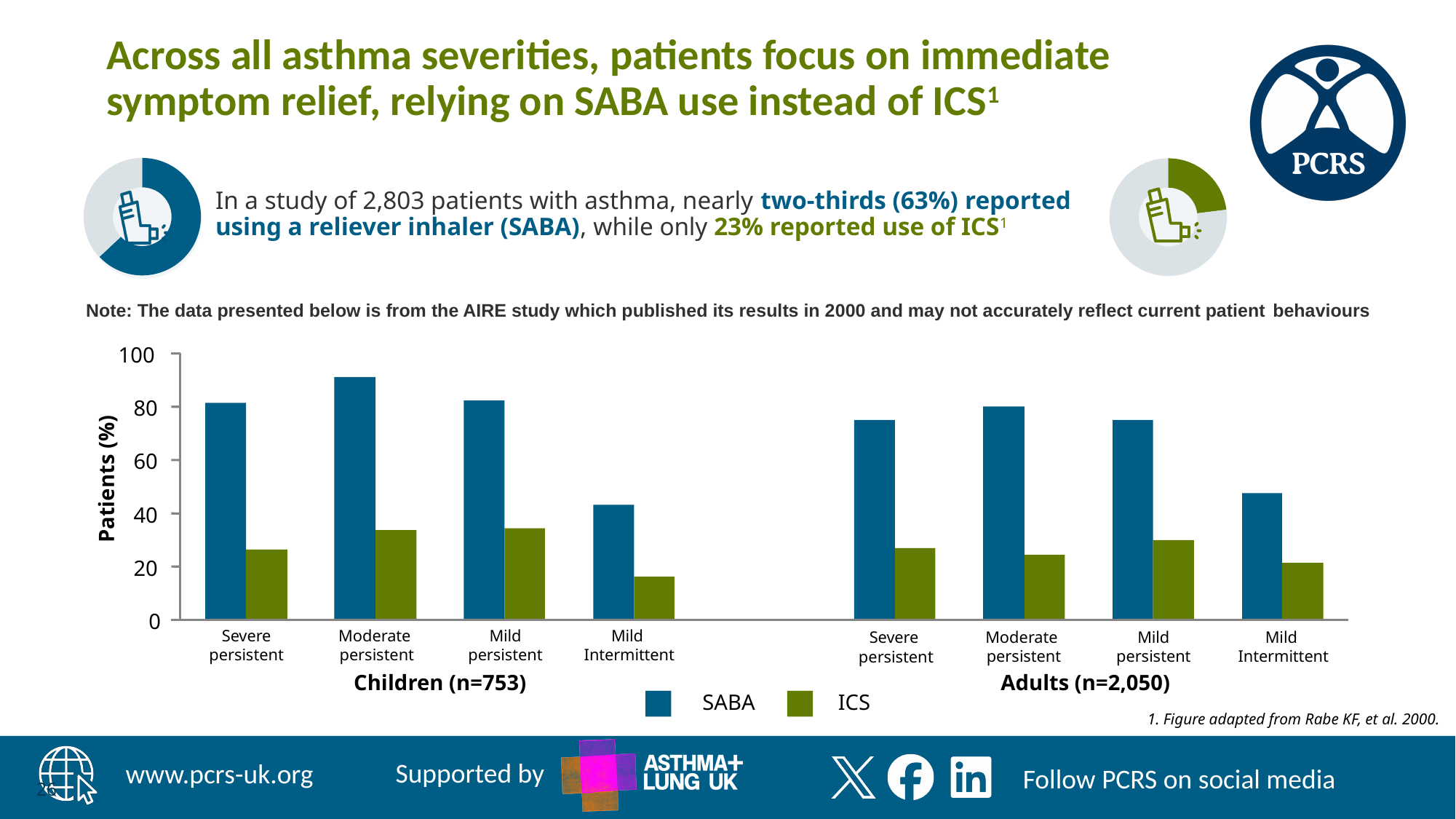
What kind of chart is shown on the slide? bar chart Is the SABA value for Moderate persistent in Children greater or less than 80? greater How many series does the chart legend list? 2 Among the Adults groups, which severity category has the lowest SABA value? Mild Intermittent Among the Children groups, which severity category has the lowest SABA value? Mild Intermittent How many category groups are plotted along the x axis of the chart? 8 Among the Children groups, which severity category has the highest SABA value? Moderate persistent Which is larger: the SABA value for Moderate persistent in Children or the SABA value for Moderate persistent in Adults? Moderate persistent in Children Is the SABA value for Mild Intermittent in Adults greater or less than 60? less What is the label of the y axis of the chart? Patients (%) Which colour represents ICS in the chart legend? green Is the ICS value for Mild Intermittent in Children greater or less than 20? less